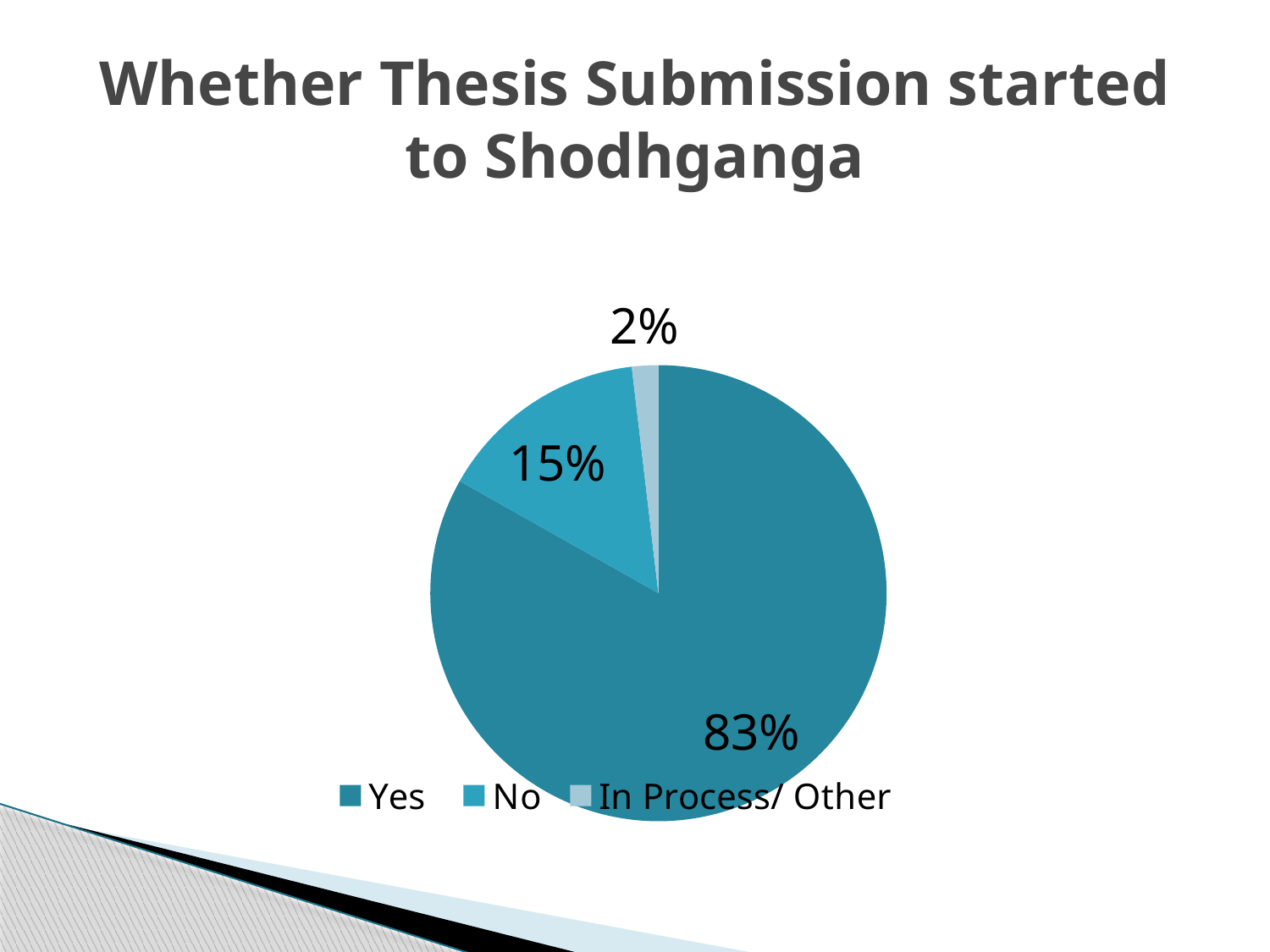
What is the difference in percentage points between the "Yes" and "No" slices? 68 Which category has the largest share of the pie? Yes What is the title of the slide? Whether Thesis Submission started to Shodhganga What percentage of the pie is labelled "In Process/ Other"? 2% Which slice is larger, "No" or "In Process/ Other"? No What is the combined share of the "No" and "In Process/ Other" slices? 17% How many slices does the pie chart have? 3 What percentage of the pie is labelled "No"? 15% What percentage of the pie is labelled "Yes"? 83% Which category has the smallest share of the pie? In Process/ Other What kind of chart is shown on the slide? pie chart How many entries does the legend list? 3